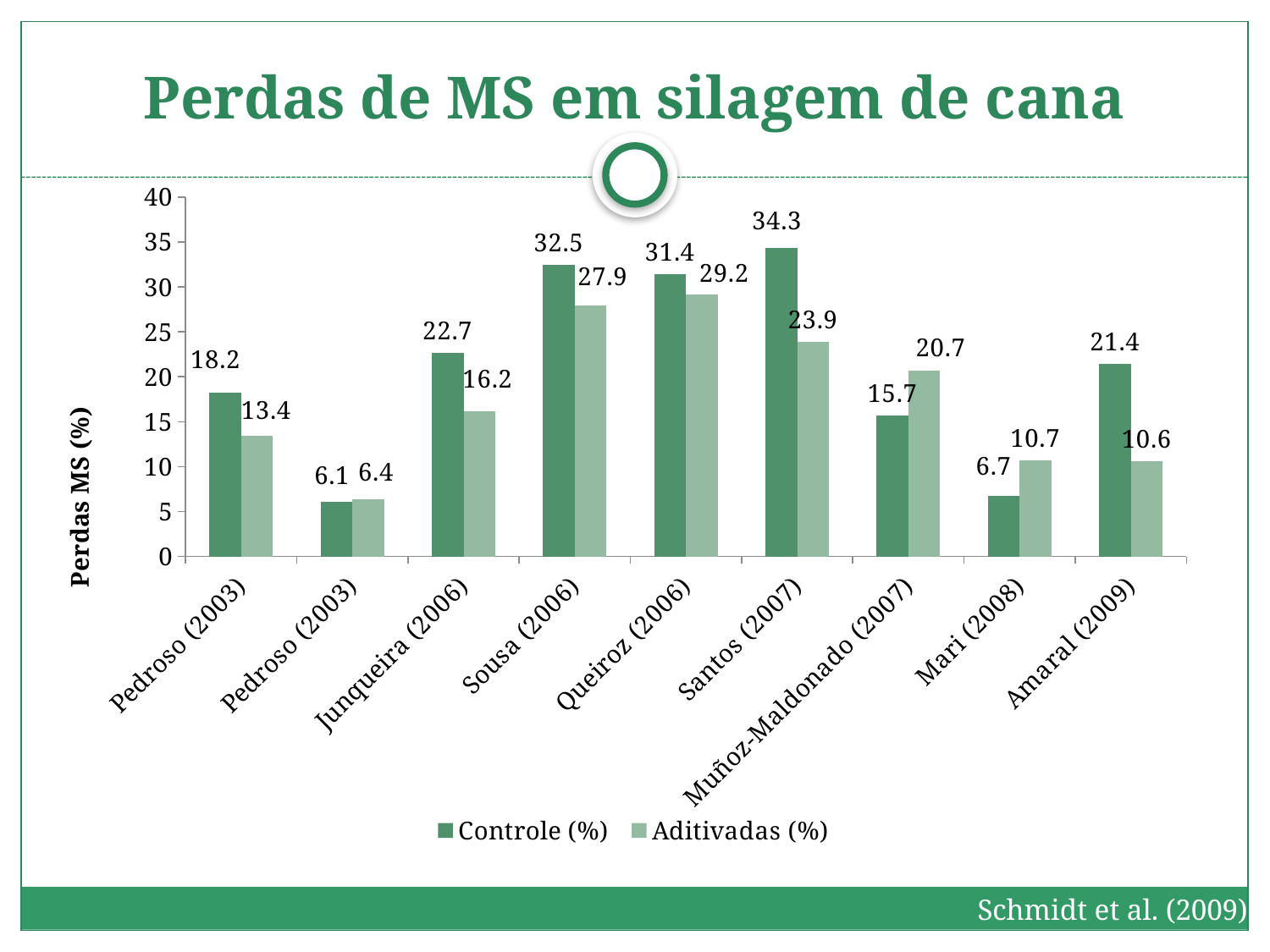
What type of chart is shown on the slide? bar chart What is the Controle (%) value for Amaral (2009)? 21.4 Which category has the highest Controle (%) value? Santos (2007) How many categories (studies) are shown on the x axis? 9 What is the Controle (%) value for Santos (2007)? 34.3 What is the title of the chart on the slide? Perdas de MS em silagem de cana What is the Aditivadas (%) value for Muñoz-Maldonado (2007)? 20.7 For Mari (2008), which is larger: the Controle (%) value or the Aditivadas (%) value? Aditivadas (%) What is the difference between the Controle (%) and Aditivadas (%) values for Santos (2007)? 10.4 What is the difference between the Controle (%) and Aditivadas (%) values for Amaral (2009)? 10.8 Which category has the highest Aditivadas (%) value? Queiroz (2006) How many series does the legend list? 2